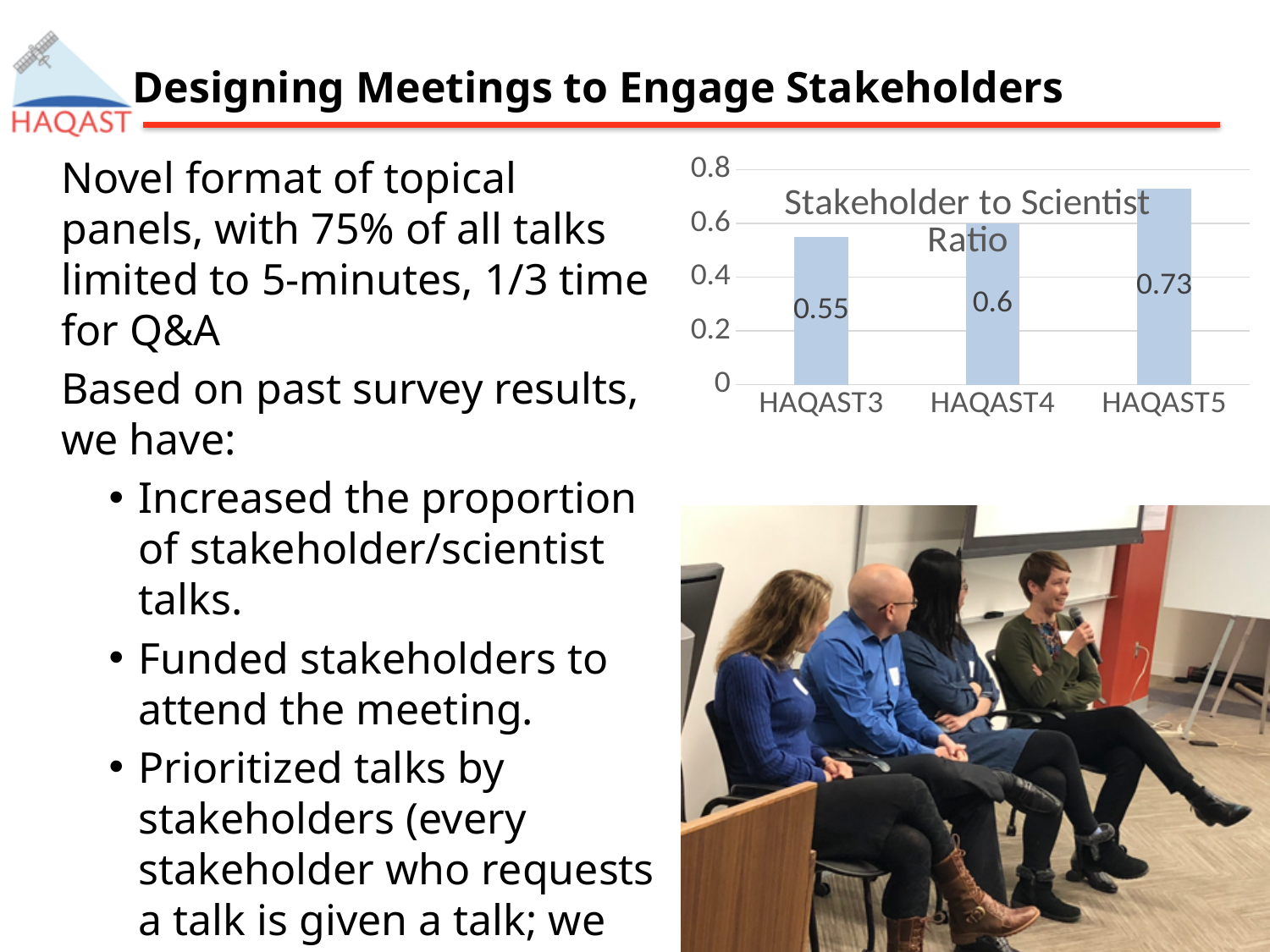
Which meeting has the highest Stakeholder to Scientist Ratio? HAQAST5 What is the Stakeholder to Scientist Ratio for HAQAST5? 0.73 Does the Stakeholder to Scientist Ratio rise or fall from HAQAST3 to HAQAST5? Rise How many meetings are shown in the Stakeholder to Scientist Ratio chart? 3 What kind of chart is used to show the Stakeholder to Scientist Ratio? Bar chart Which has a larger Stakeholder to Scientist Ratio, HAQAST4 or HAQAST5? HAQAST5 Which meeting has the lowest Stakeholder to Scientist Ratio? HAQAST3 What is the Stakeholder to Scientist Ratio for HAQAST4? 0.6 What is the difference between the Stakeholder to Scientist Ratio for HAQAST4 and HAQAST3? 0.05 What is the Stakeholder to Scientist Ratio for HAQAST3? 0.55 What is the difference between the Stakeholder to Scientist Ratio for HAQAST5 and HAQAST3? 0.18 Is the Stakeholder to Scientist Ratio for HAQAST5 greater or less than 0.6? greater